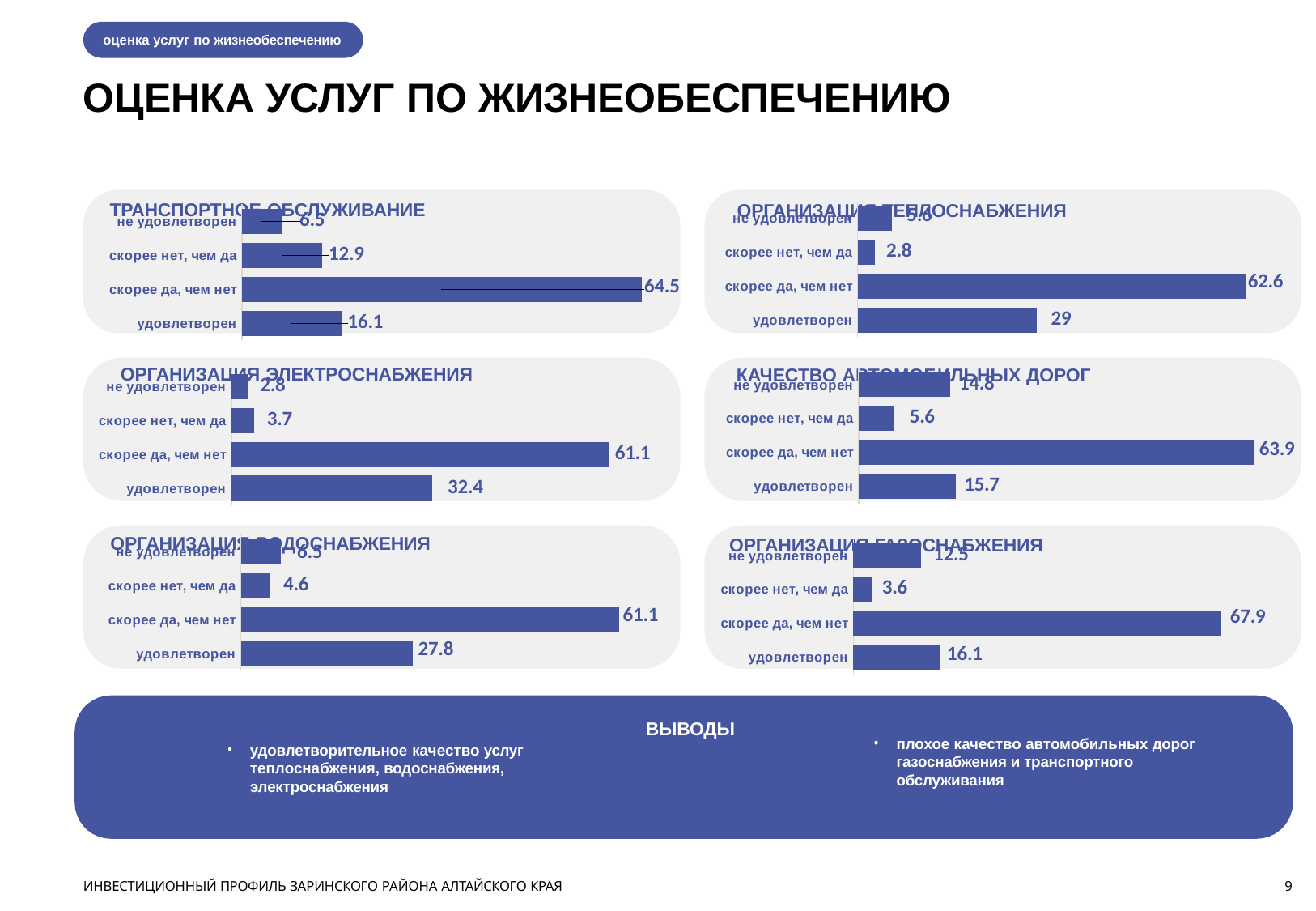
How many categories does the 'ОРГАНИЗАЦИЯ ТЕПЛОСНАБЖЕНИЯ' chart show? 4 On the 'ОРГАНИЗАЦИЯ ЭЛЕКТРОСНАБЖЕНИЯ' chart, which category has the highest value? скорее да, чем нет On the 'ТРАНСПОРТНОЕ ОБСЛУЖИВАНИЕ' chart, what is the value for 'удовлетворен'? 16.1 On the 'ТРАНСПОРТНОЕ ОБСЛУЖИВАНИЕ' chart, what is the value for 'скорее да, чем нет'? 64.5 On the 'ОРГАНИЗАЦИЯ ВОДОСНАБЖЕНИЯ' chart, which is larger: 'удовлетворен' or 'скорее нет, чем да'? удовлетворен On the 'ОРГАНИЗАЦИЯ ГАЗОСНАБЖЕНИЯ' chart, what is the difference between 'удовлетворен' and 'скорее нет, чем да'? 12.5 On the 'КАЧЕСТВО АВТОМОБИЛЬНЫХ ДОРОГ' chart, what is the difference between 'скорее да, чем нет' and 'удовлетворен'? 48.2 On the 'ОРГАНИЗАЦИЯ ЭЛЕКТРОСНАБЖЕНИЯ' chart, which category has the lowest value? не удовлетворен On the 'ОРГАНИЗАЦИЯ ТЕПЛОСНАБЖЕНИЯ' chart, what is the value for 'удовлетворен'? 29 On the 'ОРГАНИЗАЦИЯ ГАЗОСНАБЖЕНИЯ' chart, what is the value for 'скорее да, чем нет'? 67.9 How many charts are shown on the slide? 6 What kind of chart is the 'КАЧЕСТВО АВТОМОБИЛЬНЫХ ДОРОГ' chart? Bar chart